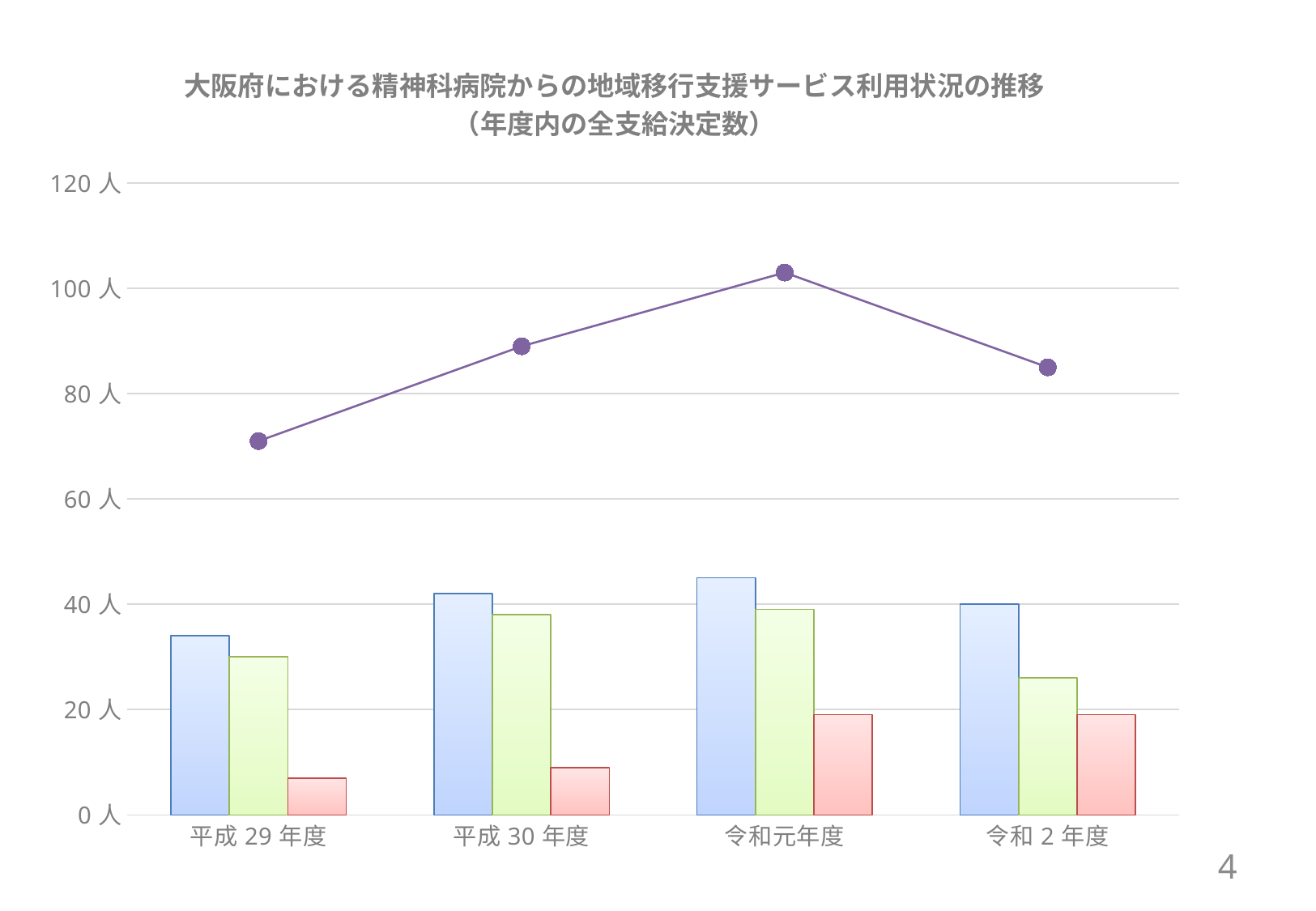
Is the value of the blue bar for 令和元年度 greater or less than 40人? greater How does the purple line change from 平成29年度 to 令和2年度? It rises until 令和元年度, then falls Is the value of the purple line for 令和元年度 greater or less than 100人? greater In which fiscal year does the purple line reach its highest point? 令和元年度 How many fiscal-year categories are shown on the x axis? 4 In which fiscal year is the purple line at its lowest point? 平成29年度 Is the value of the purple line for 平成29年度 greater or less than 80人? less For 令和2年度, which is larger, the blue bar or the green bar? The blue bar What kind of chart is shown on the slide? A combined bar and line chart In which fiscal year is the green bar the lowest? 令和2年度 What is the title of the chart? 大阪府における精神科病院からの地域移行支援サービス利用状況の推移（年度内の全支給決定数）